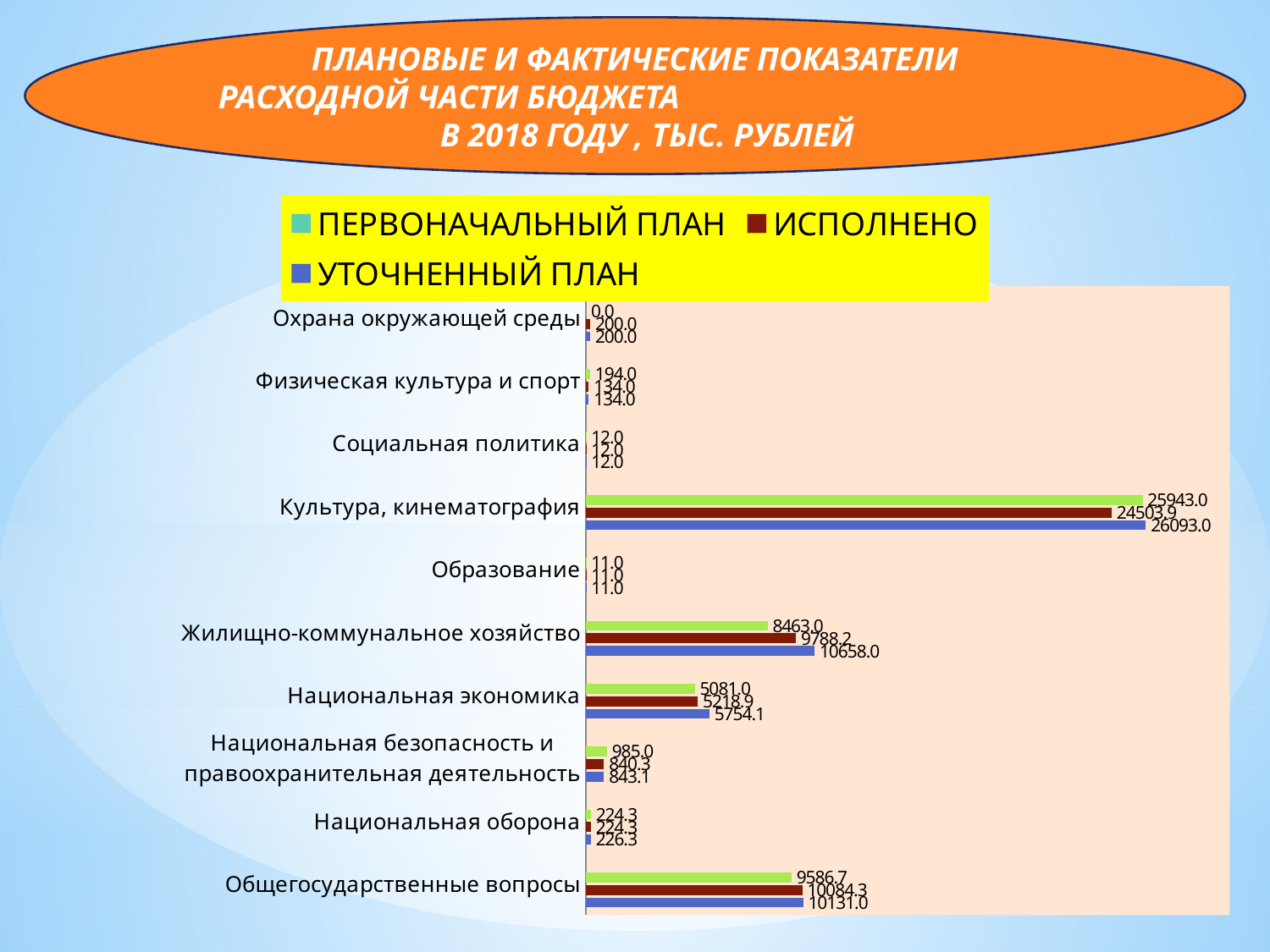
Which is larger for Жилищно-коммунальное хозяйство: the ПЕРВОНАЧАЛЬНЫЙ ПЛАН or the УТОЧНЕННЫЙ ПЛАН? УТОЧНЕННЫЙ ПЛАН Which series is shown in green in the legend? ПЕРВОНАЧАЛЬНЫЙ ПЛАН What is the УТОЧНЕННЫЙ ПЛАН value for Национальная экономика? 5754.1 How many categories are shown on the chart? 10 What kind of chart is shown on the slide? bar chart Which category has the highest УТОЧНЕННЫЙ ПЛАН value? Культура, кинематография What is the УТОЧНЕННЫЙ ПЛАН value for Культура, кинематография? 26093.0 What is the ПЕРВОНАЧАЛЬНЫЙ ПЛАН value for Общегосударственные вопросы? 9586.7 What is the ПЕРВОНАЧАЛЬНЫЙ ПЛАН value for Национальная безопасность и правоохранительная деятельность? 985.0 How many series does the legend list? 3 What is the ИСПОЛНЕНО value for Жилищно-коммунальное хозяйство? 9788.2 What is the difference between the УТОЧНЕННЫЙ ПЛАН and ПЕРВОНАЧАЛЬНЫЙ ПЛАН values for Культура, кинематография? 150.0